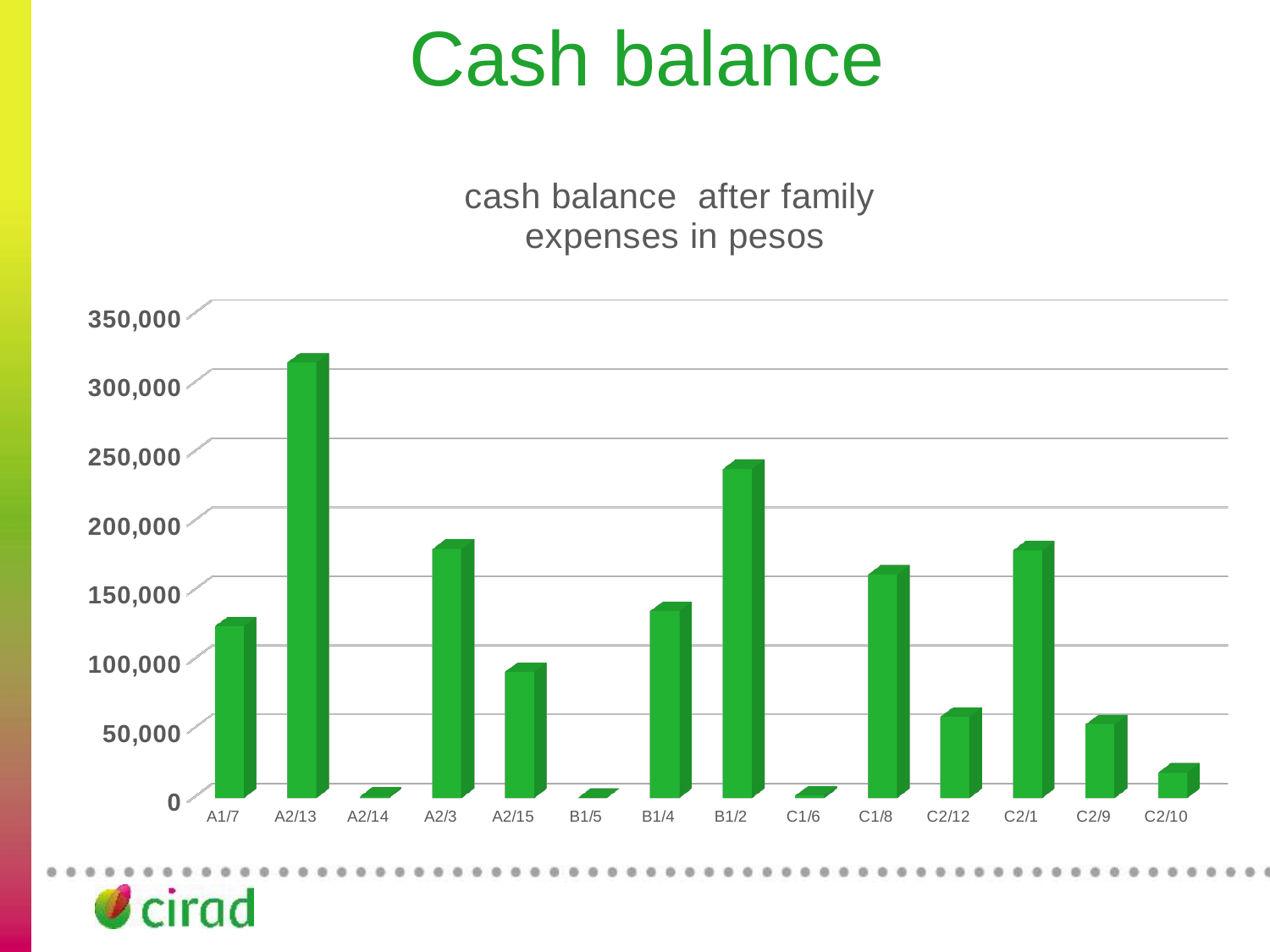
Which is larger, the value for A2/13 or the value for B1/2? A2/13 Is the value for A2/15 greater or less than 100,000? less Is the value for A1/7 greater or less than 100,000? greater Is the value for A2/13 greater or less than 300,000? greater Which is larger, the value for C1/8 or the value for C2/9? C1/8 Which category has the highest cash balance? A2/13 What is the title of the chart? cash balance after family expenses in pesos How many categories are plotted along the x axis of the chart? 14 What kind of chart is shown on the slide? bar chart